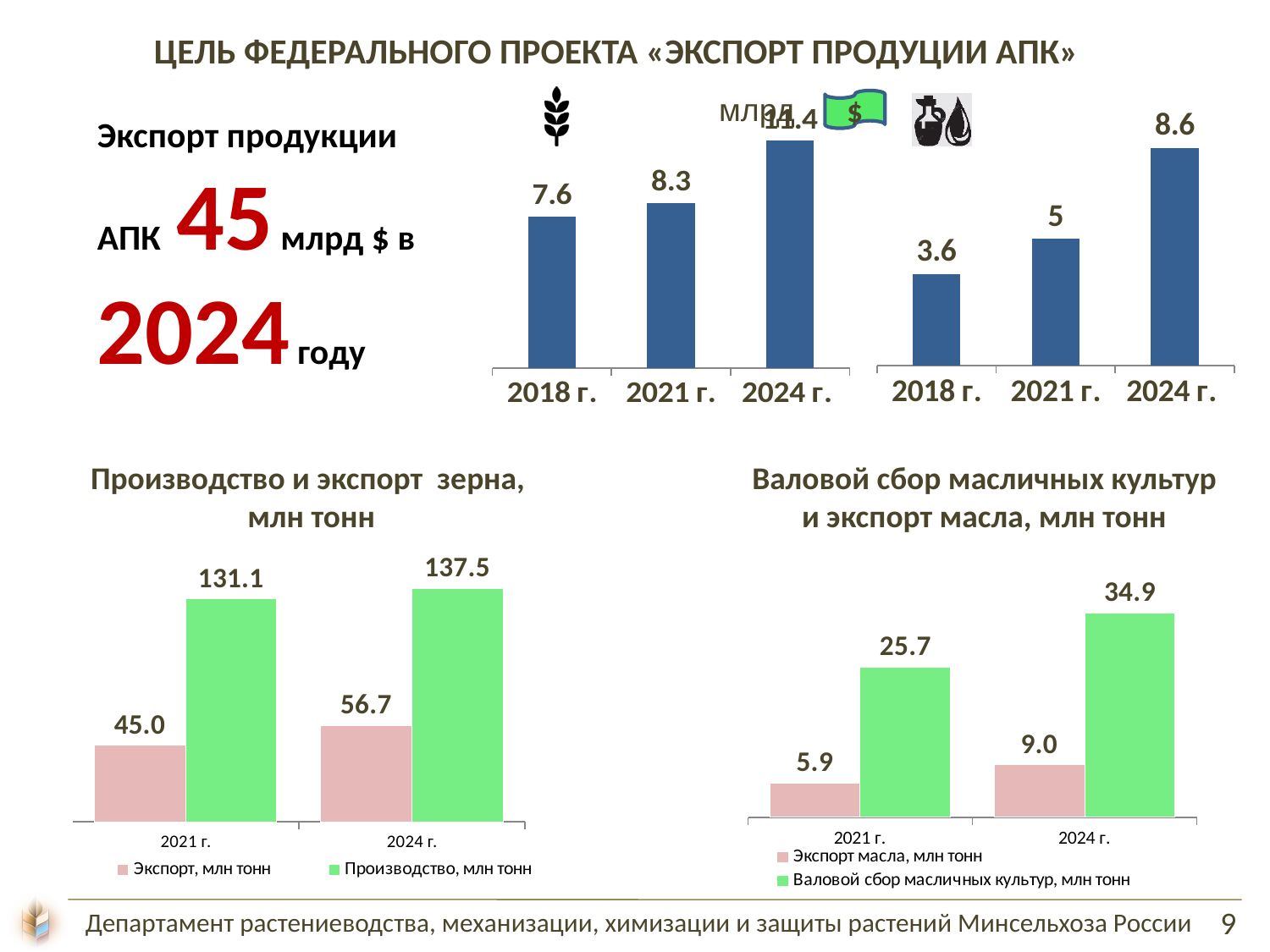
In the chart 'Валовой сбор масличных культур и экспорт масла, млн тонн', what is the value of 'Экспорт масла, млн тонн' for 2024 г.? 9.0 In the chart 'Производство и экспорт зерна, млн тонн', what is the value of 'Производство, млн тонн' for 2024 г.? 137.5 In the chart 'Производство и экспорт зерна, млн тонн', what is the value of 'Экспорт, млн тонн' for 2021 г.? 45.0 In the chart 'Валовой сбор масличных культур и экспорт масла, млн тонн', what is the difference between 'Валовой сбор масличных культур, млн тонн' in 2024 г. and 2021 г.? 9.2 In the top-right bar chart (with the oil icon), which year has the highest value? 2024 г. In the top-right bar chart (with the oil icon), what is the value for 2018 г.? 3.6 In the top-left bar chart (with the wheat icon), which year has the lowest value? 2018 г. How many series does the legend of the chart 'Валовой сбор масличных культур и экспорт масла, млн тонн' list? 2 In the chart 'Производство и экспорт зерна, млн тонн', what is the difference between 'Экспорт, млн тонн' in 2024 г. and in 2021 г.? 11.7 In the top-left bar chart (with the wheat icon), what is the value for 2021 г.? 8.3 In the chart 'Валовой сбор масличных культур и экспорт масла, млн тонн', what is the value of 'Валовой сбор масличных культур, млн тонн' for 2021 г.? 25.7 In the top-right bar chart (with the oil icon), do the values rise or fall from 2018 г. to 2024 г.? rise